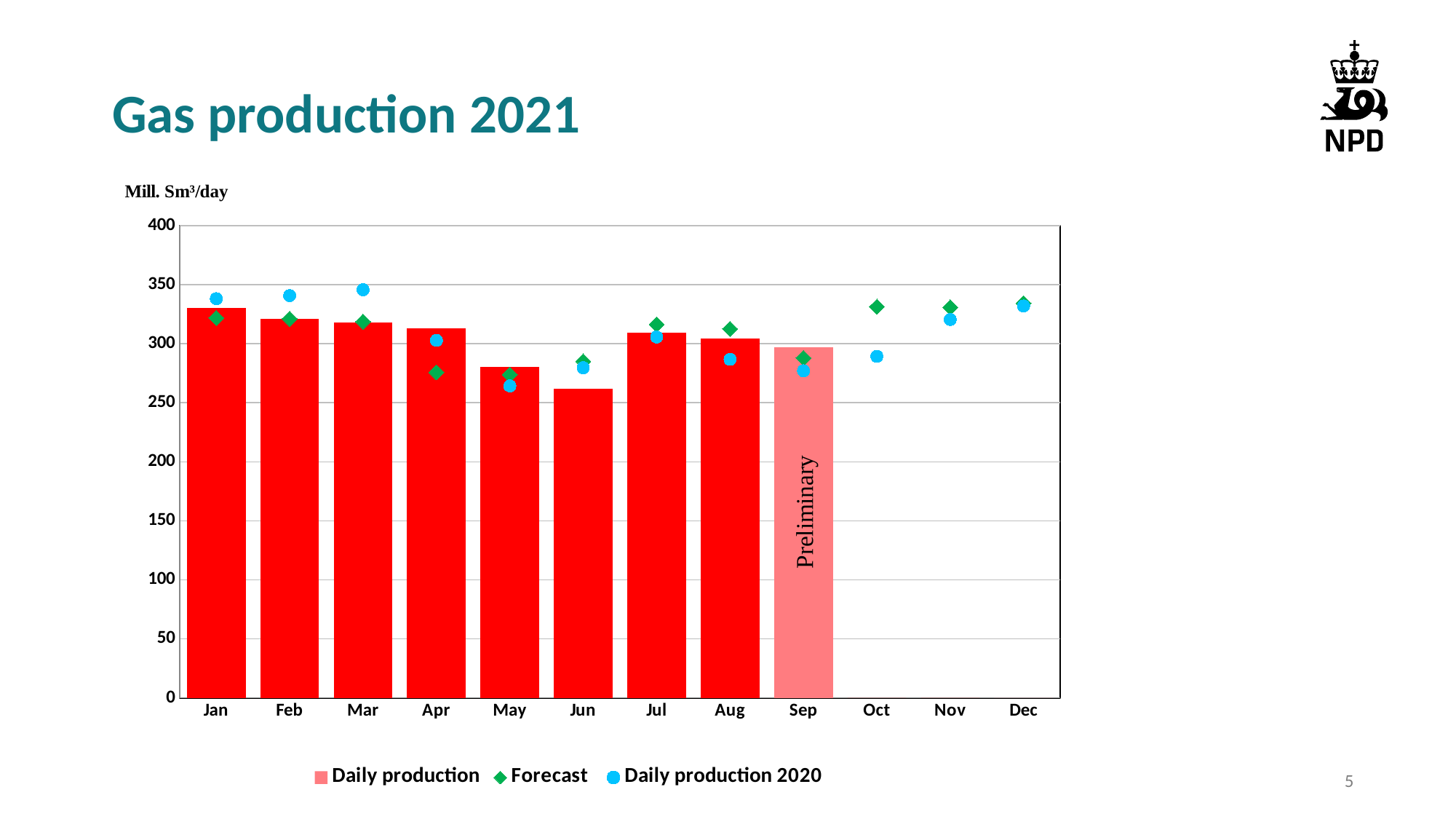
Do the Daily production bars rise or fall from Jan to Jun? fall Is the Daily production value for Jan greater or less than 300? greater Is the Daily production 2020 value for Mar greater or less than 300? greater Which month's Daily production bar is labelled 'Preliminary'? Sep How many series does the legend list? 3 Which month has the highest Daily production bar? Jan Which month has the lowest Daily production bar? Jun What kind of chart is shown on the slide? bar chart Which is larger, the Daily production bar for Apr or for May? Apr How many months have a Daily production bar plotted? 9 Is the Daily production value for Jun greater or less than 300? less How many months are shown on the x axis? 12